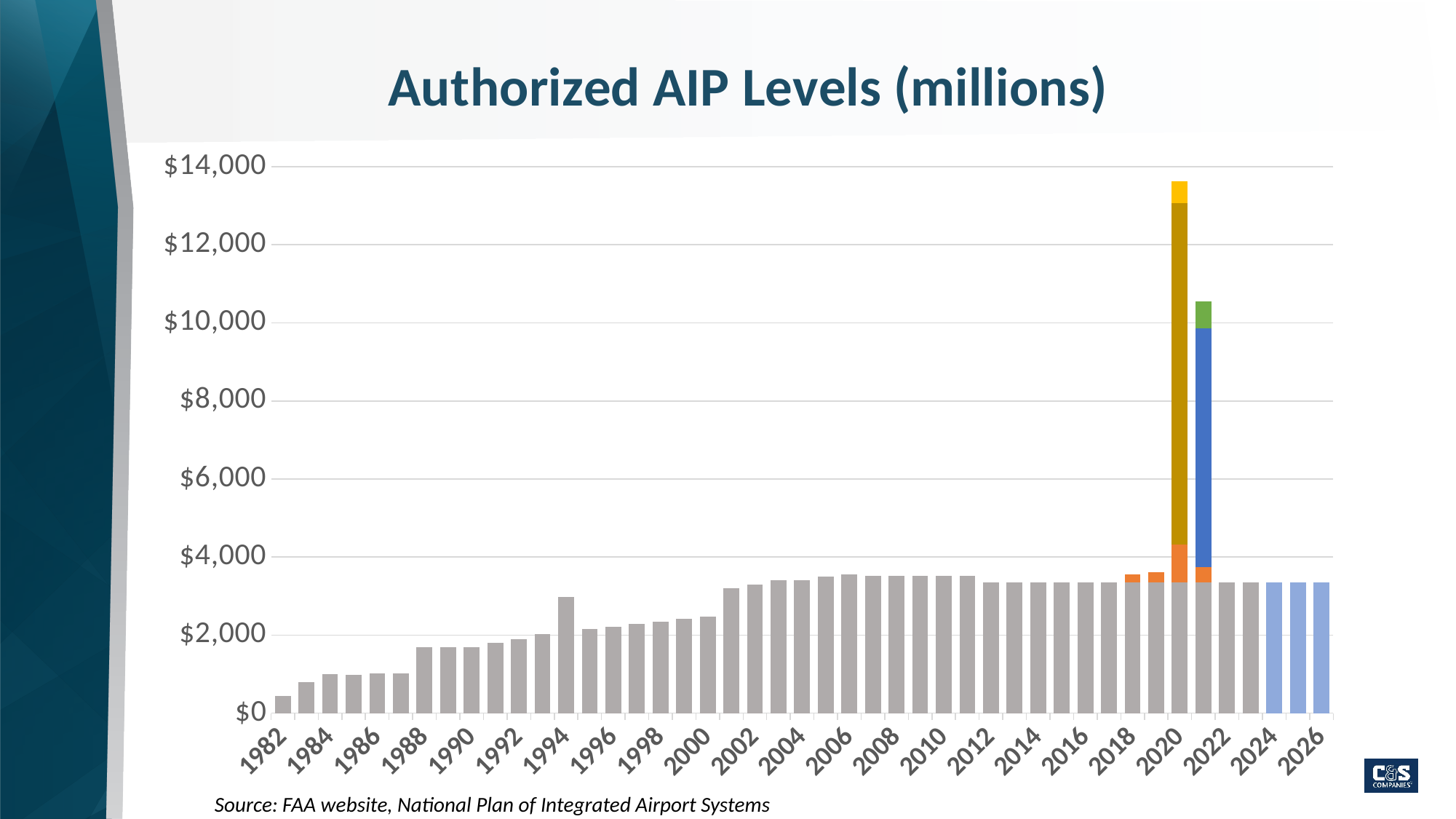
Is the total value for 2020 greater or less than $12,000? greater Is the value for 1982 greater or less than $2,000? less Is the total value for 2021 greater or less than $10,000? greater What is the title of the chart? Authorized AIP Levels (millions) Which year has the larger value, 1986 or 1988? 1988 Which year has the highest total authorized AIP level? 2020 Which year has the larger total value, 2020 or 2021? 2020 Do the values generally rise or fall from 1982 to 1994? rise What kind of chart is shown on the slide? Bar chart Which year has the lowest authorized AIP level? 1982